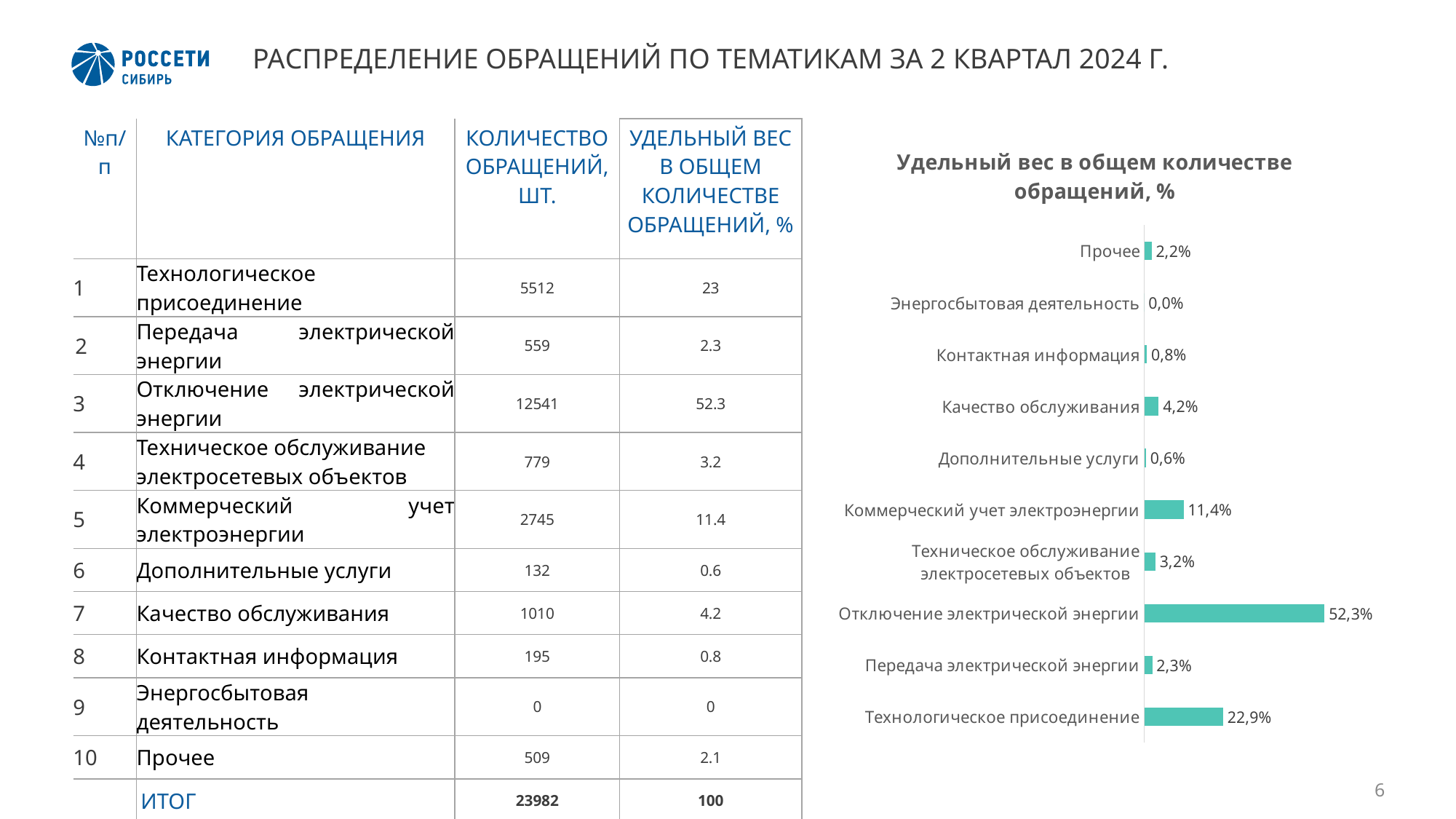
What is the value for Качество обслуживания in the chart? 4,2% What is the difference between the values for Прочее and Передача электрической энергии? 0,1% What kind of chart is shown on the slide? Bar chart What is the value for Технологическое присоединение in the chart? 22,9% What is the difference between the values for Отключение электрической энергии and Технологическое присоединение? 29,4% What is the value for Отключение электрической энергии in the chart? 52,3% Which category has the lowest value in the chart? Энергосбытовая деятельность Which is larger: the value for Коммерческий учет электроэнергии or the value for Качество обслуживания? Коммерческий учет электроэнергии What is the title of the chart? Удельный вес в общем количестве обращений, % What is the value for Коммерческий учет электроэнергии in the chart? 11,4% Which category has the highest value in the chart? Отключение электрической энергии How many categories are shown in the chart? 10